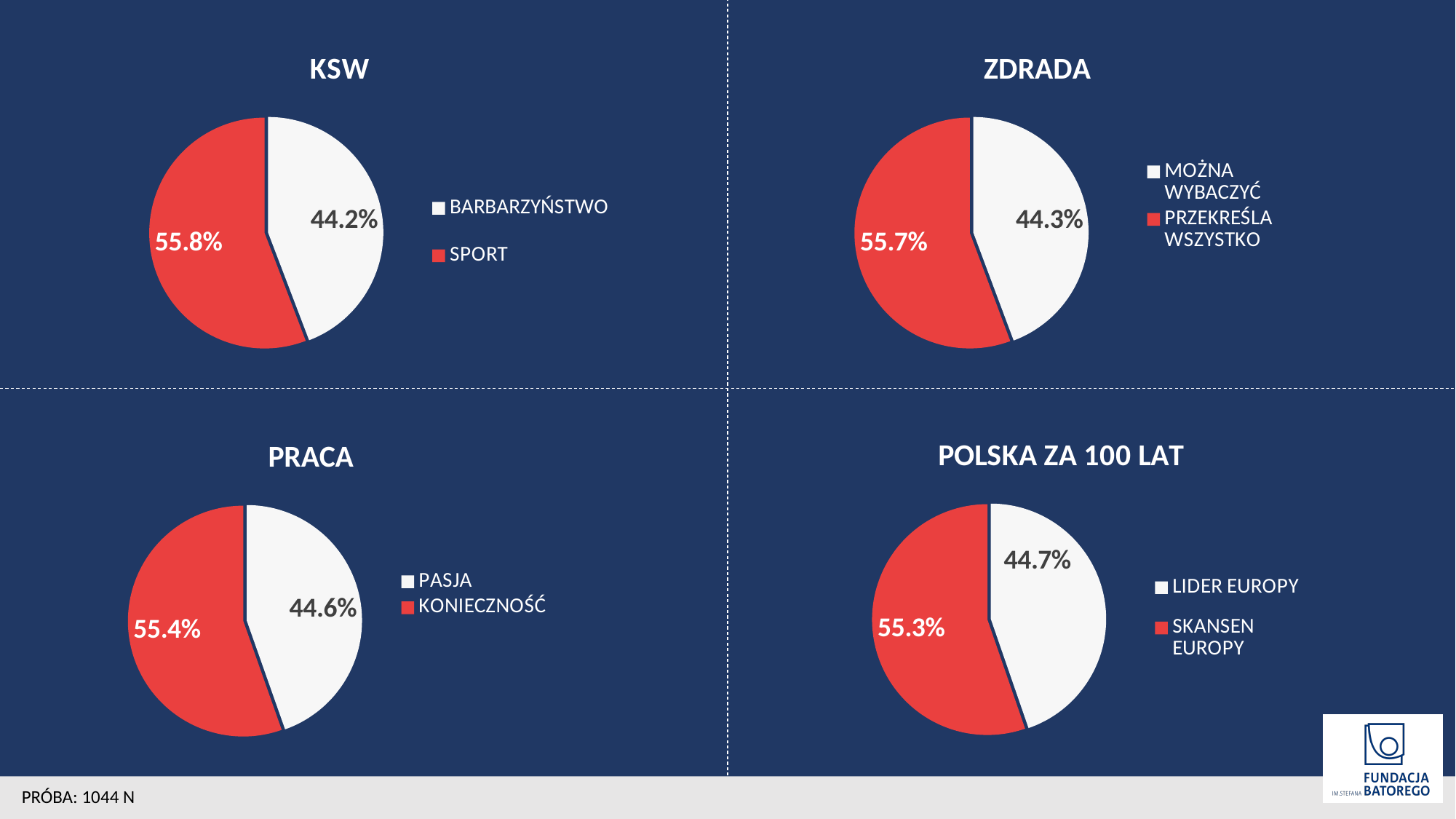
How many slices does the POLSKA ZA 100 LAT pie chart have? 2 In the PRACA chart, which slice is larger, PASJA or KONIECZNOŚĆ? KONIECZNOŚĆ In the ZDRADA chart, what is the value for MOŻNA WYBACZYĆ? 44.3% What type of chart is used in the ZDRADA chart? Pie chart In the POLSKA ZA 100 LAT chart, what is the value for LIDER EUROPY? 44.7% In the KSW chart, what share of respondents chose SPORT? 55.8% In the KSW chart, what share of respondents chose BARBARZYŃSTWO? 44.2% In the PRACA chart, what is the value for KONIECZNOŚĆ? 55.4% In the PRACA chart, what is the difference between the KONIECZNOŚĆ and PASJA shares? 10.8% In the POLSKA ZA 100 LAT chart, which category has the largest share? SKANSEN EUROPY In the KSW chart, what is the difference between the SPORT and BARBARZYŃSTWO shares? 11.6% In the ZDRADA chart, what is the value for PRZEKREŚLA WSZYSTKO? 55.7%